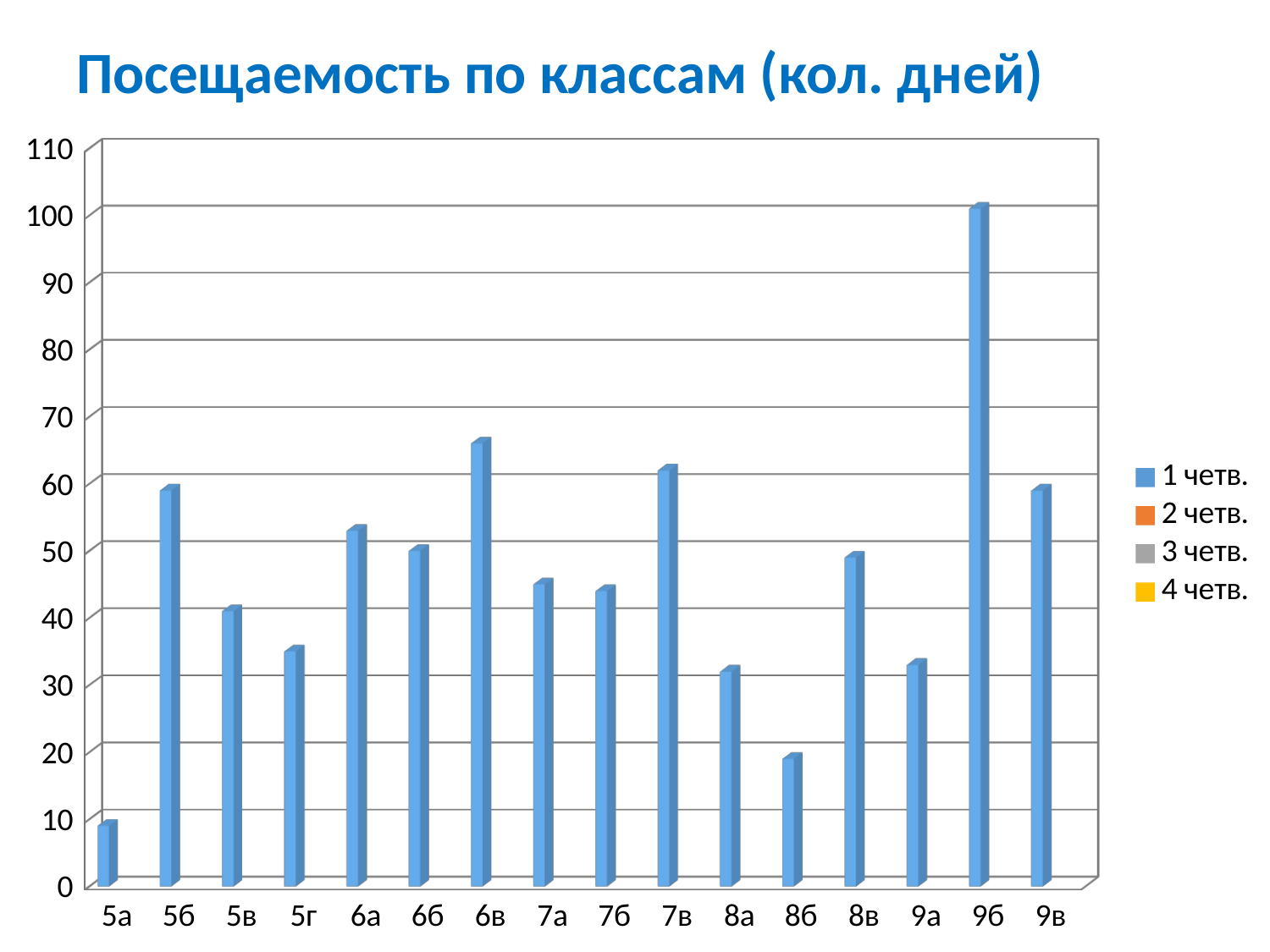
Which is larger, the value for 5б or the value for 5в? 5б What kind of chart is shown on the slide? bar chart Is the value for 9б greater or less than 90? greater Which class has the highest value? 9б What is the title of the chart? Посещаемость по классам (кол. дней) Is the value for 5а greater or less than 10? less Is the value for 6в greater or less than 60? greater How many classes (categories) are shown on the x axis? 16 Which class has the lowest value? 5а How many series does the legend list? 4 Which is larger, the value for 8а or the value for 8б? 8а